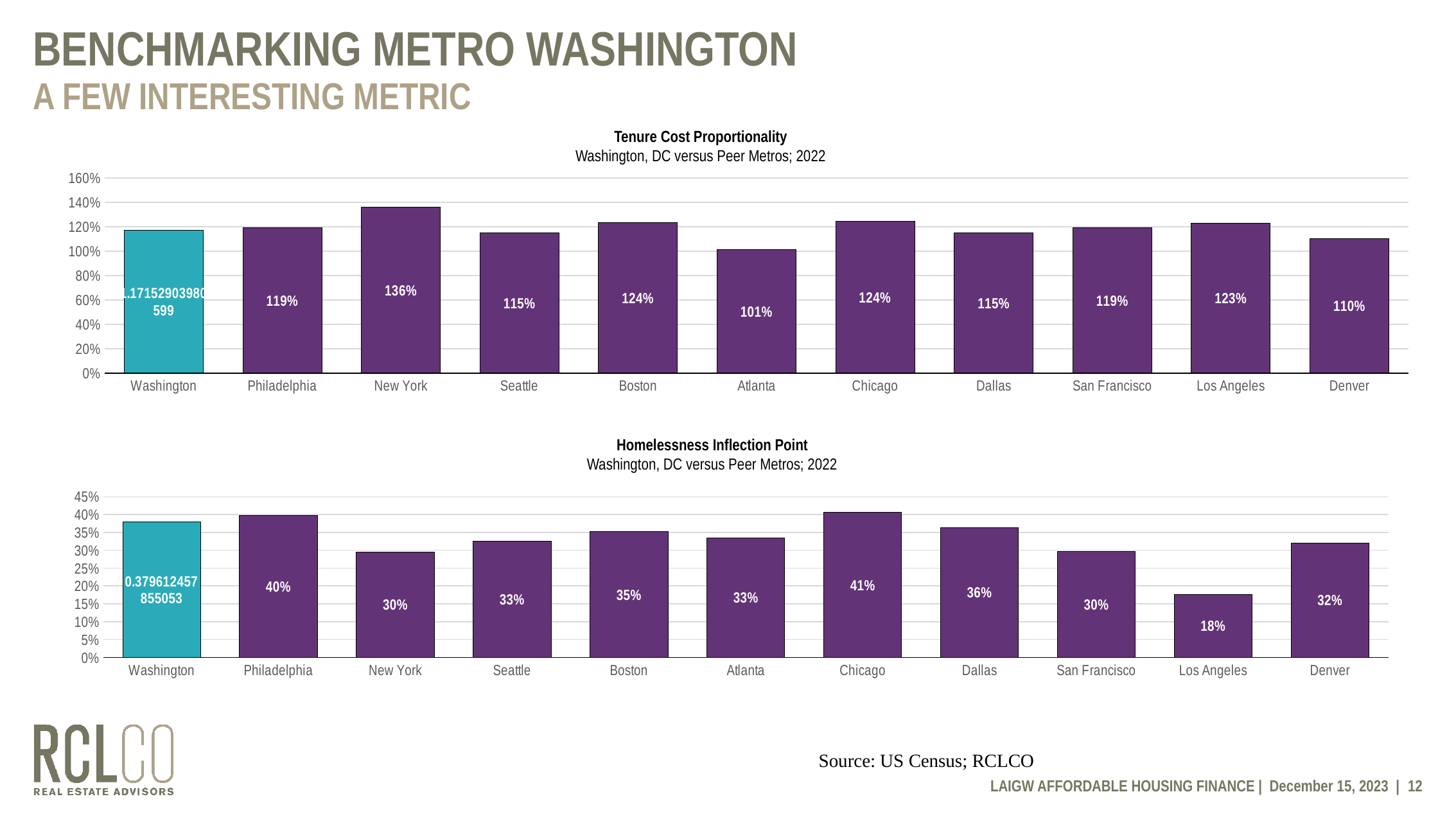
In the Homelessness Inflection Point chart, what is the value for Los Angeles? 18% In the Tenure Cost Proportionality chart, which metro has the lowest value? Atlanta What type of chart is the Homelessness Inflection Point chart? Bar chart In the Tenure Cost Proportionality chart, which metro has the highest value? New York In the Homelessness Inflection Point chart, which metro has the lowest value? Los Angeles In the Tenure Cost Proportionality chart, what is the value for Atlanta? 101% In the Tenure Cost Proportionality chart, what is the value for New York? 136% In the Tenure Cost Proportionality chart, what is the difference between Boston and Denver? 14% In the Homelessness Inflection Point chart, which is larger, Boston or San Francisco? Boston In the Tenure Cost Proportionality chart, how many metros are shown on the x axis? 11 In the Homelessness Inflection Point chart, what is the value for Dallas? 36% In the Homelessness Inflection Point chart, is the value for Washington greater or less than 35%? greater